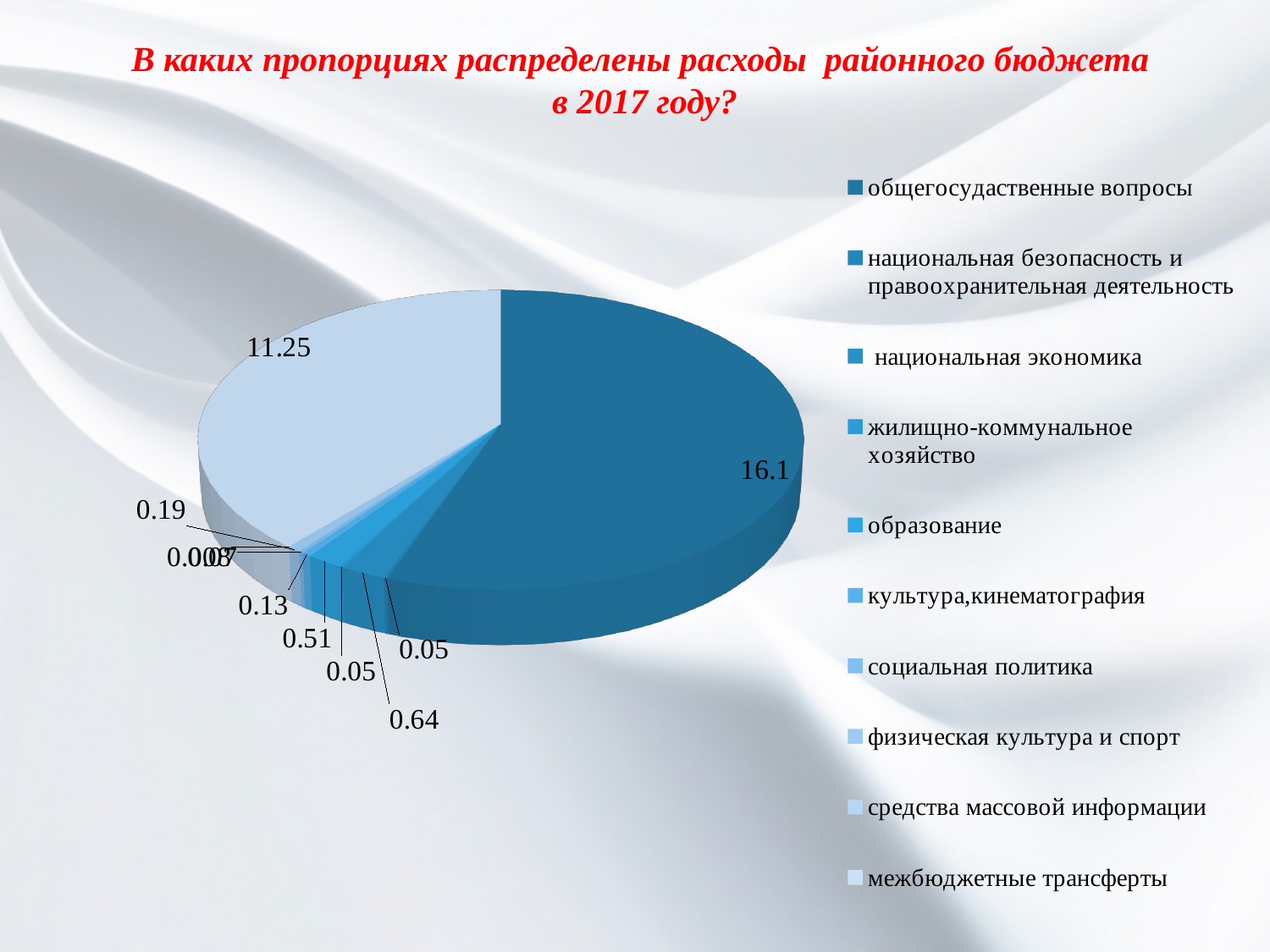
What is the difference between the two largest slices, labelled 16.1 and 11.25? 4.85 Is the value of the largest slice greater or less than 15? greater Which year does the chart title refer to? 2017 What is the second-largest value labelled on the pie chart? 11.25 What value is shown for the slice 'межбюджетные трансферты' (the large light blue slice)? 11.25 How many categories does the legend of the pie chart list? 10 What is the last entry listed in the chart legend? межбюджетные трансферты Which is larger, the slice labelled 16.1 or the slice labelled 11.25? 16.1 What kind of chart is shown on the slide? pie chart What value is shown for the slice 'общегосударственные вопросы' (the large dark blue slice)? 16.1 What is the largest value labelled on the pie chart? 16.1